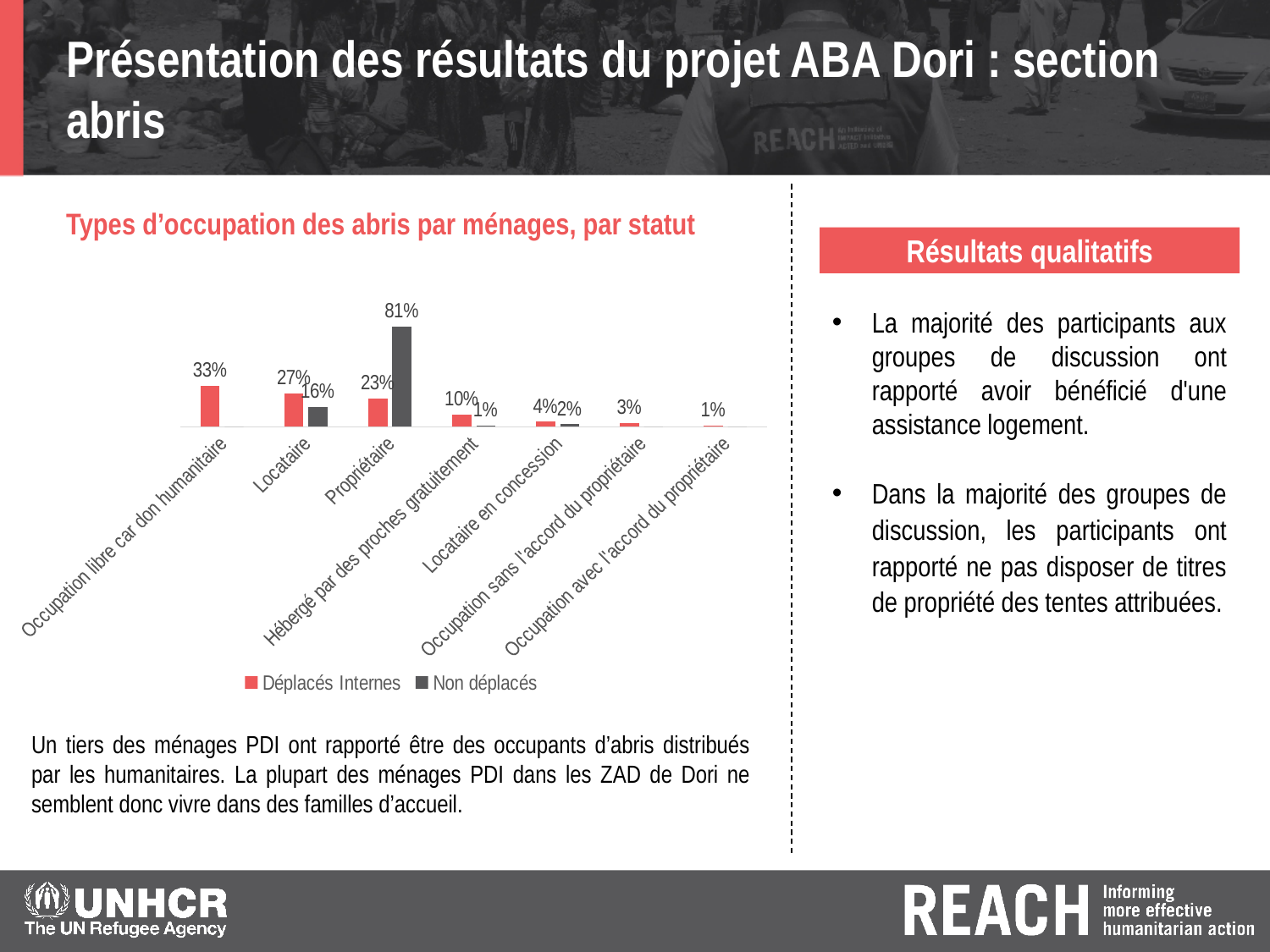
In the 'Propriétaire' category, what is the difference between the Non déplacés value and the Déplacés Internes value? 58 percentage points What is the value for Déplacés Internes in the 'Hébergé par des proches gratuitement' category? 10% What is the value for Déplacés Internes in the 'Locataire' category? 27% What is the value for Non déplacés in the 'Locataire' category? 16% How many occupation type categories are shown on the x axis of the chart? 7 What is the value for Non déplacés in the 'Propriétaire' category? 81% Which category has the highest value for the Déplacés Internes series? Occupation libre car don humanitaire What percentage of Déplacés Internes households are in the 'Occupation libre car don humanitaire' category? 33% How many series does the chart legend list? 2 Which category has the highest value for the Non déplacés series? Propriétaire In the 'Locataire' category, which series has the larger value, Déplacés Internes or Non déplacés? Déplacés Internes What type of chart is used to show the types of shelter occupation? Bar chart